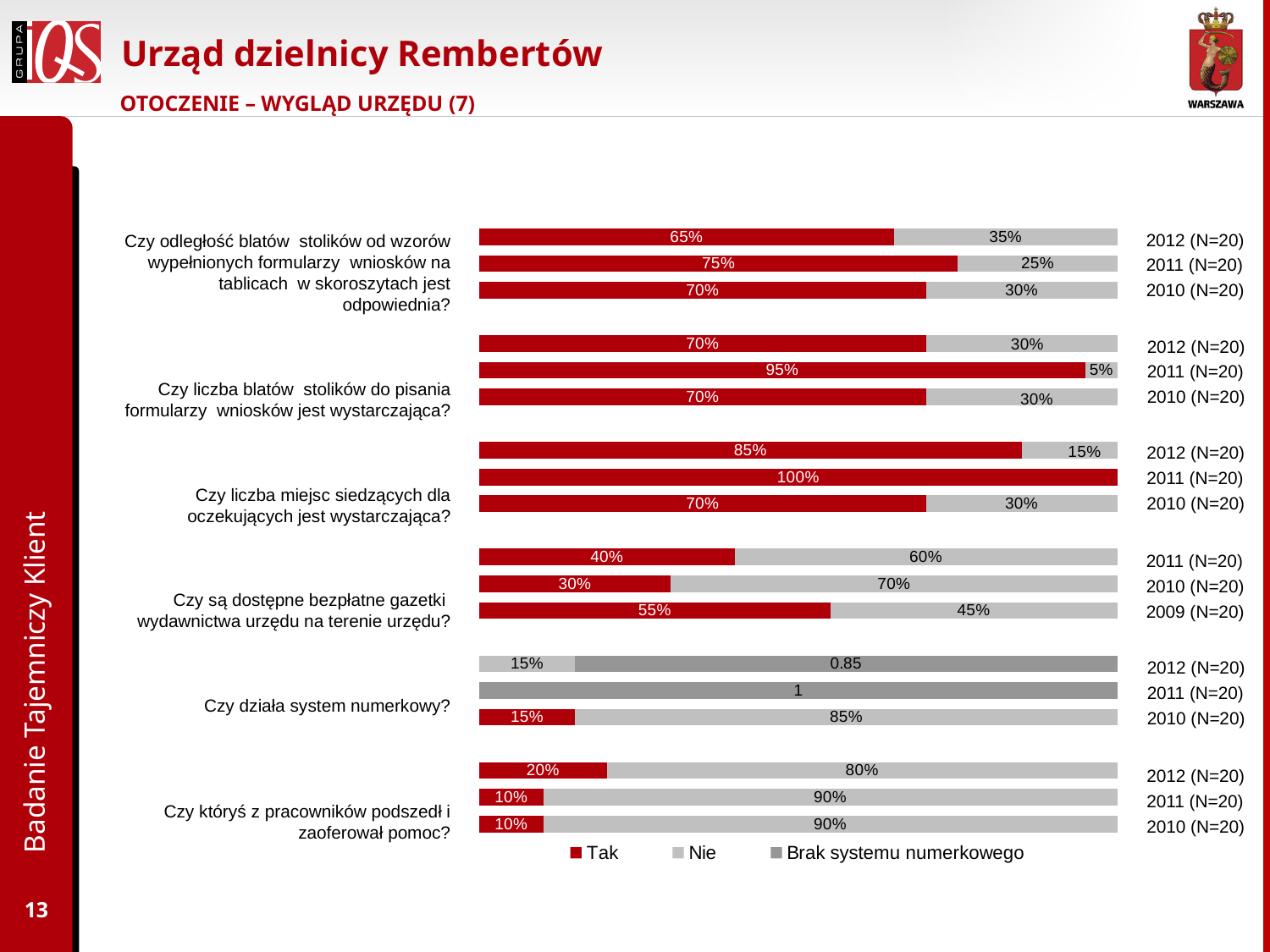
What is the "Nie" value for 2009 for the question "Czy są dostępne bezpłatne gazetki wydawnictwa urzędu na terenie urzędu?"? 45% What is the "Nie" value for 2010 for the question "Czy działa system numerkowy?"? 85% For the question "Czy odległość blatów stolików od wzorów wypełnionych formularzy wniosków na tablicach w skoroszytach jest odpowiednia?", how much higher is the "Tak" value in 2011 than in 2012? 10 percentage points What is the "Tak" value for 2011 for the question "Czy liczba miejsc siedzących dla oczekujących jest wystarczająca?"? 100% What is the "Brak systemu numerkowego" value for 2012 for the question "Czy działa system numerkowy?"? 0.85 What type of chart is shown on the slide? Stacked bar chart For the question "Czy są dostępne bezpłatne gazetki wydawnictwa urzędu na terenie urzędu?", which year has the highest "Tak" value? 2009 How many series does the chart legend list? 3 For the question "Czy są dostępne bezpłatne gazetki wydawnictwa urzędu na terenie urzędu?", which year has the larger "Tak" value, 2011 or 2010? 2011 What is the "Tak" value for 2012 for the question "Czy któryś z pracowników podszedł i zaoferował pomoc?"? 20% What are the legend entries of the chart? Tak, Nie, Brak systemu numerkowego What is the "Tak" value for 2011 for the question "Czy liczba blatów stolików do pisania formularzy wniosków jest wystarczająca?"? 95%